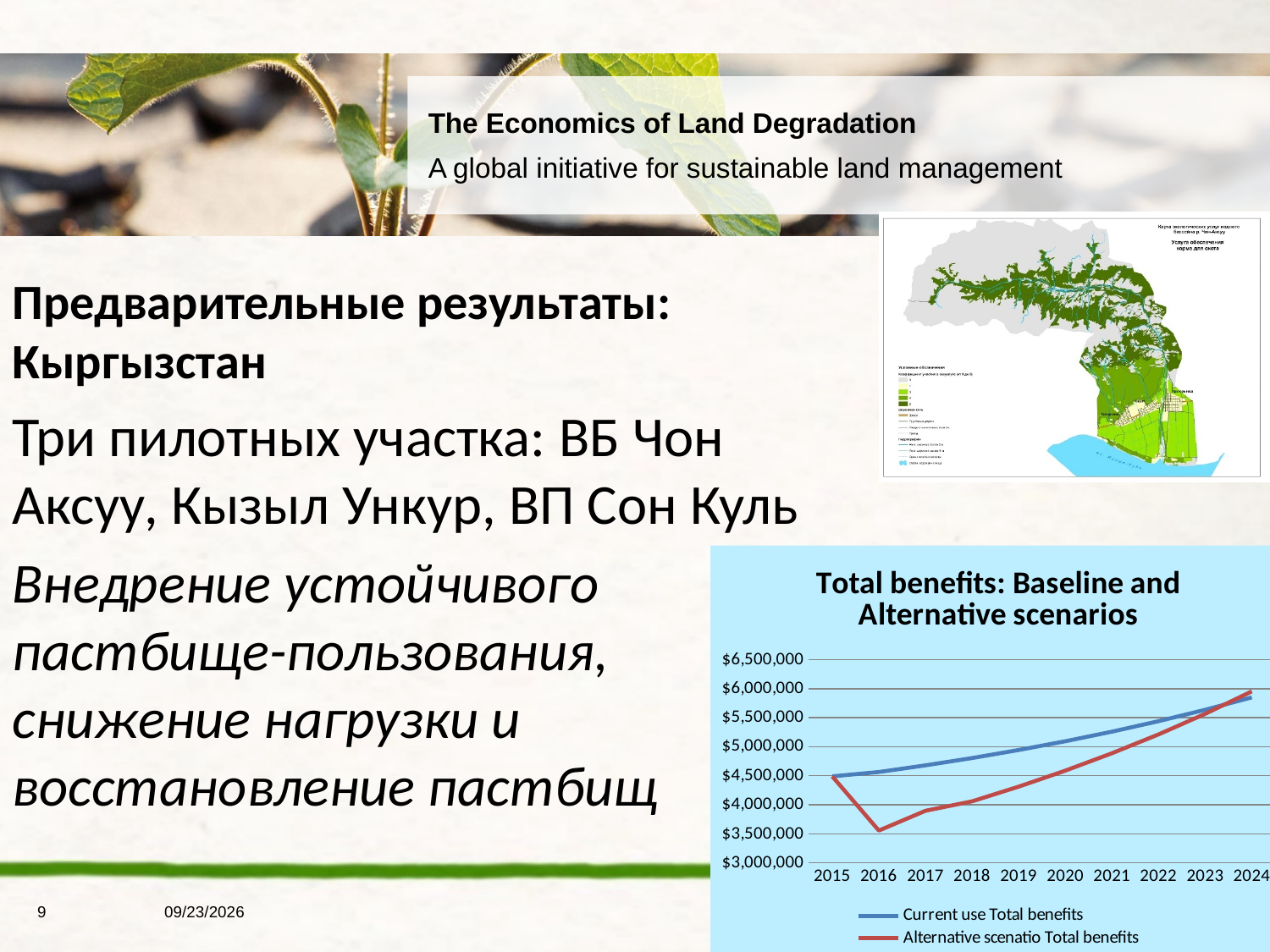
Do the Current use Total benefits values rise or fall from 2015 to 2024? rise How many series does the chart's legend list? 2 In 2016, which series has the larger value, Current use Total benefits or Alternative scenatio Total benefits? Current use Total benefits What kind of chart is shown on the slide? line chart Is the value for Alternative scenatio Total benefits in 2020 greater or less than $5,000,000? less What is the title of the chart on the slide? Total benefits: Baseline and Alternative scenarios How many years are shown on the x axis of the chart? 10 Is the value for Current use Total benefits in 2015 greater or less than $5,000,000? less Is the value for Alternative scenatio Total benefits in 2016 greater or less than $4,000,000? less In which year is the Alternative scenatio Total benefits value lowest? 2016 Which series is drawn in red in the chart? Alternative scenatio Total benefits